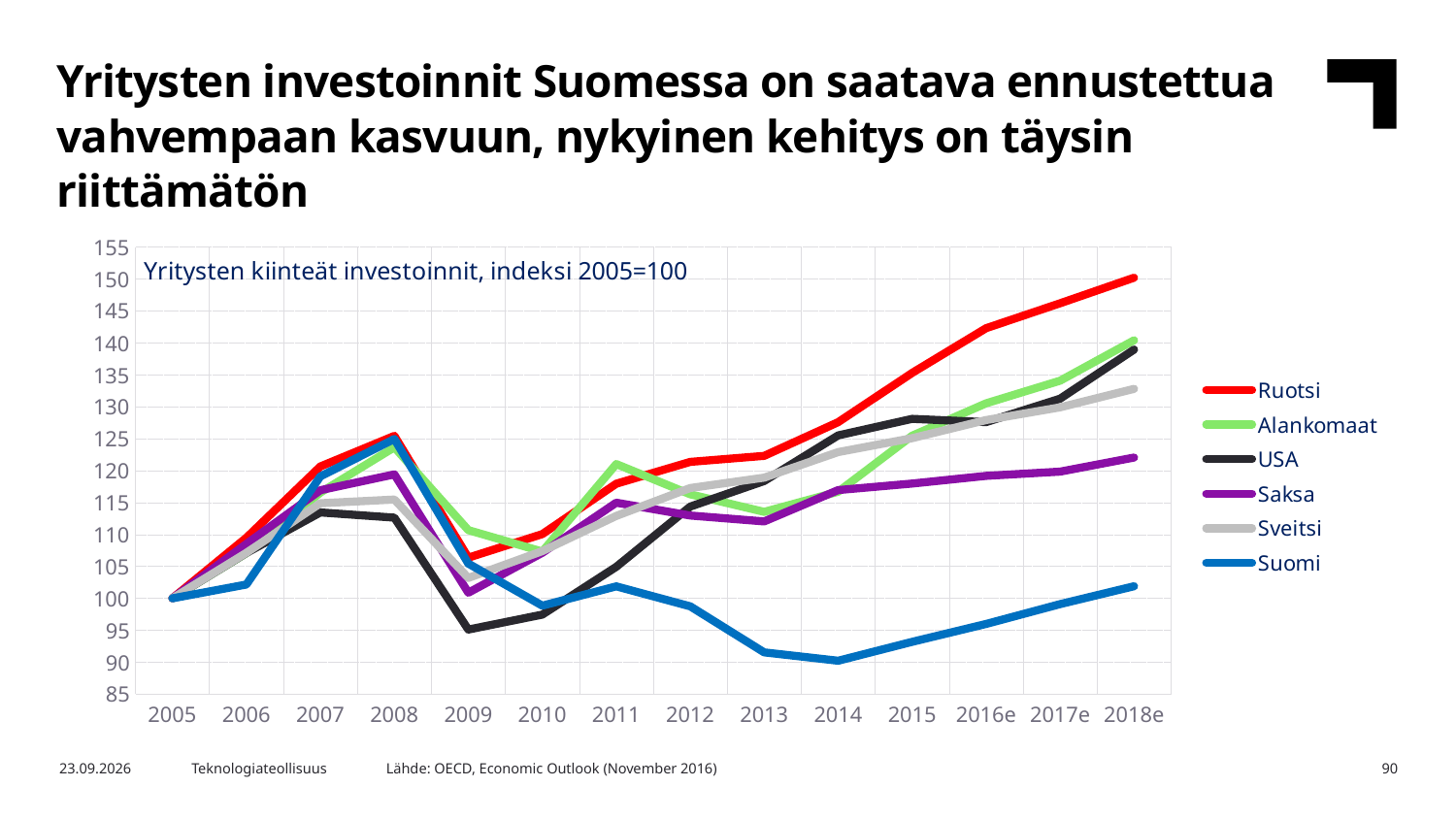
Which is larger in 2016e, the value for Ruotsi or the value for Suomi? Ruotsi Is the value for Ruotsi in 2018e greater or less than 145? greater What is the index value for Ruotsi in 2005? 100 Is the value for USA in 2009 greater or less than 100? less Does the value for Suomi rise or fall from 2014 to 2018e? rise How many years are shown on the x axis? 14 How many series does the legend list? 6 What is the title printed inside the chart area? Yritysten kiinteät investoinnit, indeksi 2005=100 Is the value for Suomi in 2014 greater or less than 95? less Which country has the highest value in 2018e? Ruotsi What kind of chart is shown on the slide? line chart Which country has the lowest value in 2018e? Suomi